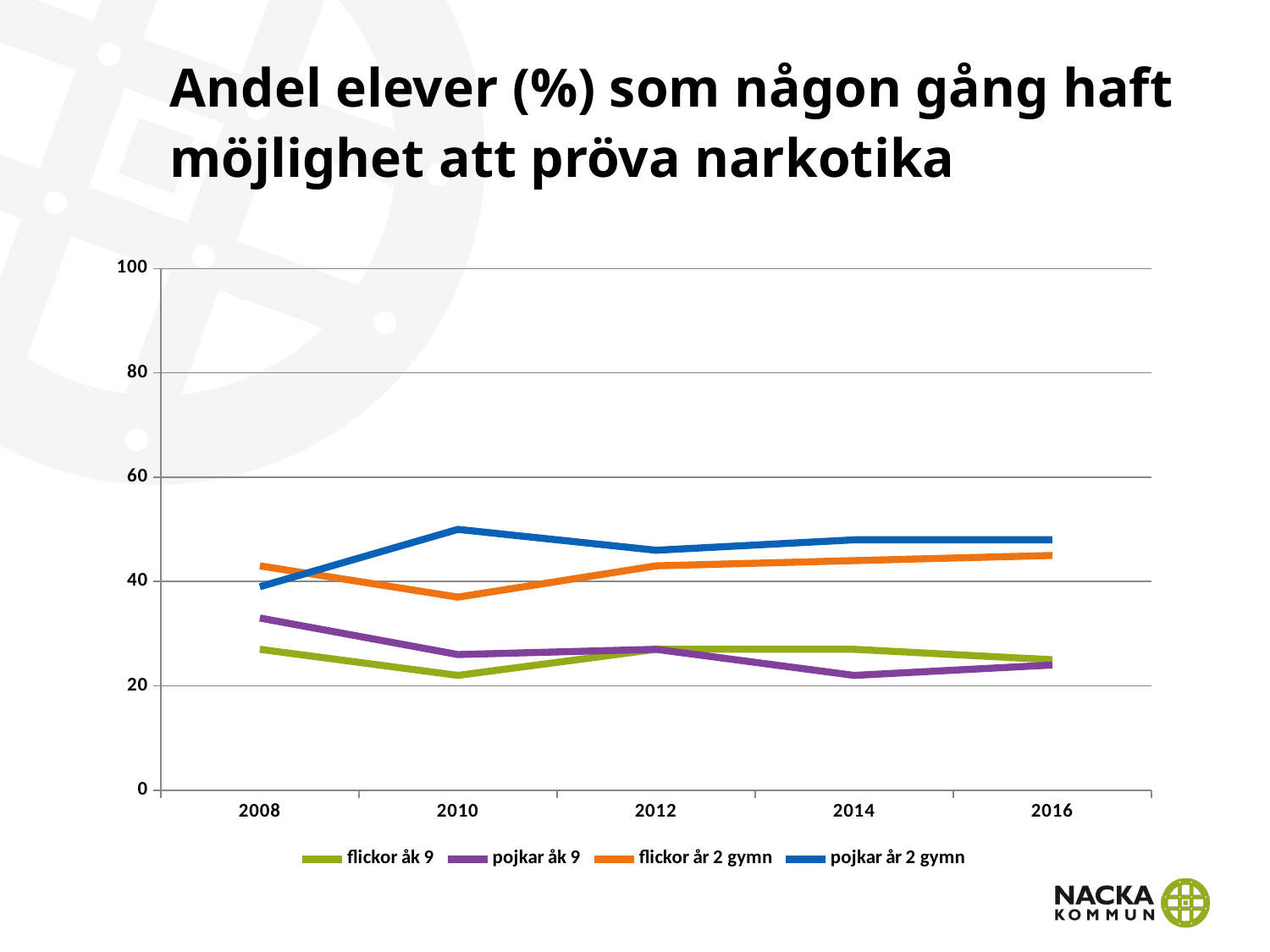
Does the value for pojkar år 2 gymn rise or fall from 2008 to 2010? rise Which series has the highest value in 2010? pojkar år 2 gymn Is the value for flickor år 2 gymn in 2016 greater or less than 40? greater Is the value for pojkar åk 9 in 2008 greater or less than 20? greater Is the value for pojkar år 2 gymn in 2010 greater or less than 40? greater Which series is drawn in orange according to the legend? flickor år 2 gymn What kind of chart is shown on the slide? line chart In 2008, which is larger: the value for pojkar åk 9 or the value for flickor åk 9? pojkar åk 9 Which series has the lowest value in 2014? pojkar åk 9 How many years are plotted along the x axis? 5 How many series does the legend list? 4